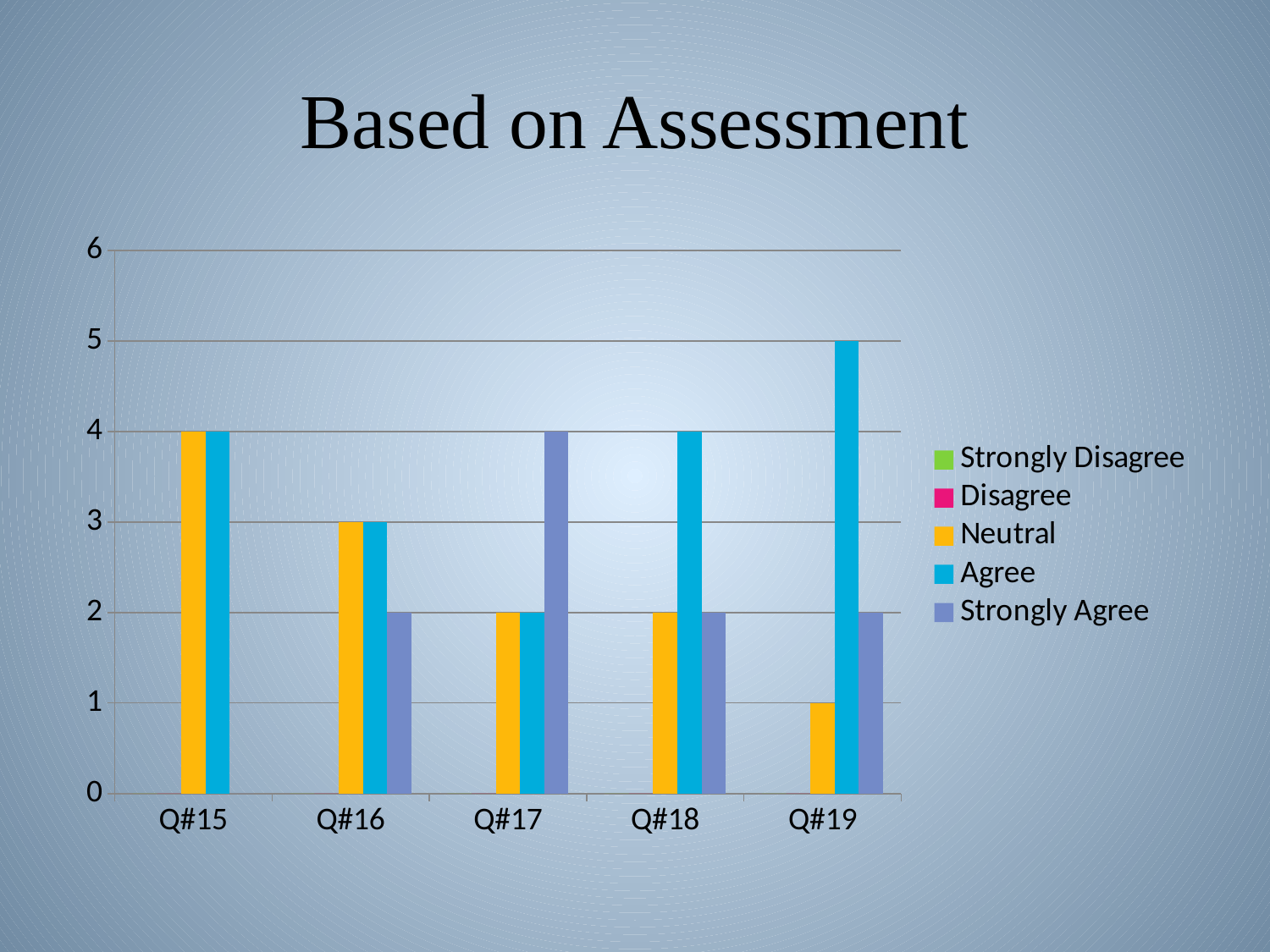
Which question has the highest Agree value? Q#19 How many question categories are shown on the x axis? 5 What type of chart is shown on the slide? bar chart How many series does the legend list? 5 What is the Neutral value for Q#19? 1 Which is larger for Q#17, the Strongly Agree value or the Agree value? Strongly Agree What is the Neutral value for Q#16? 3 What is the Strongly Agree value for Q#17? 4 What is the difference between the Agree value and the Neutral value for Q#18? 2 Which question has the lowest Neutral value? Q#19 What is the title of the chart? Based on Assessment What is the Agree value for Q#19? 5